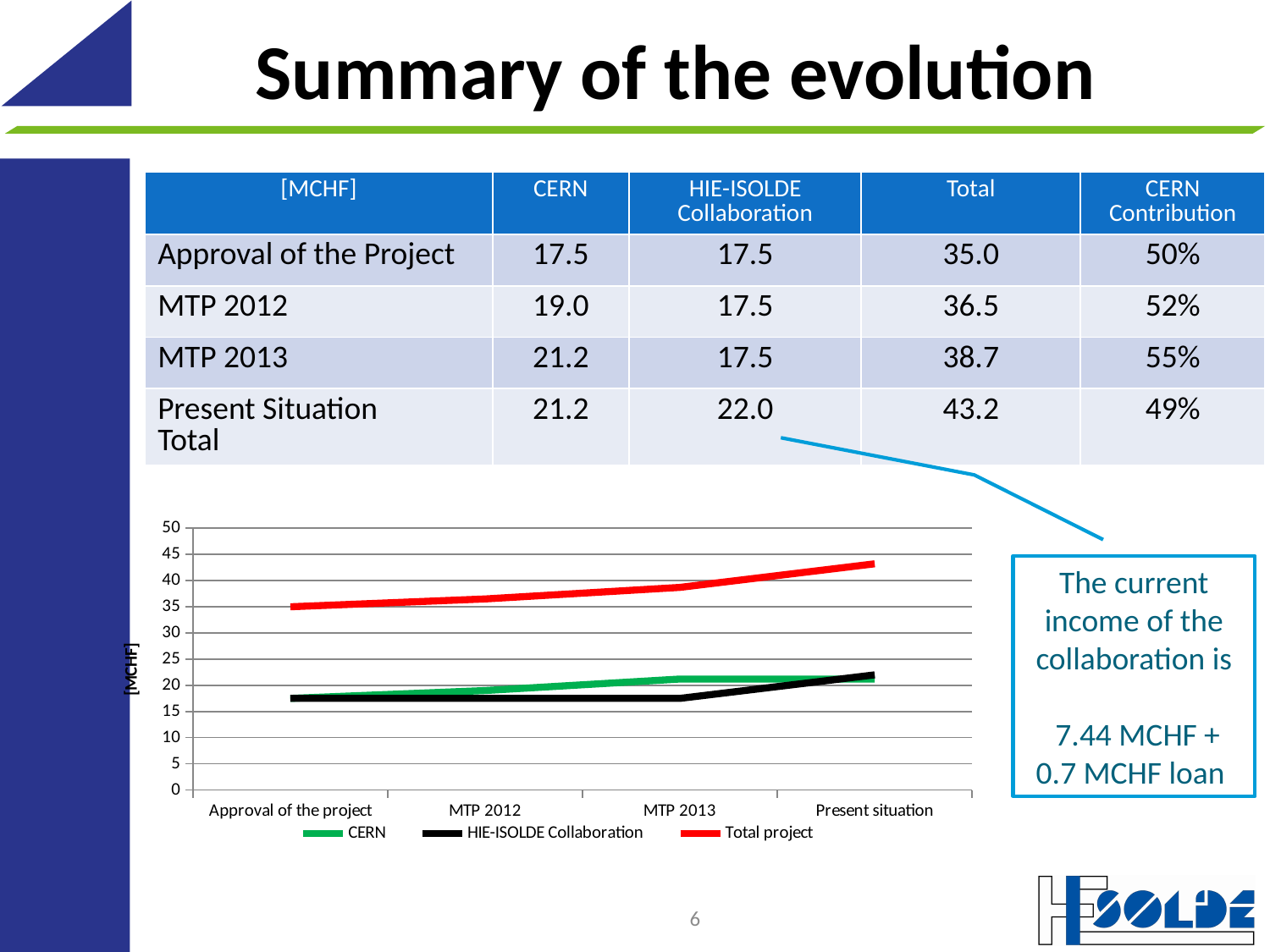
At MTP 2013, which is larger: the CERN line or the HIE-ISOLDE Collaboration line? CERN Is the value of the CERN line at Approval of the project greater or less than 20? less At which x-axis category does the Total project line reach its highest value? Present situation How many series does the chart legend list? 3 Is the value of the Total project line at Present situation greater or less than 40? greater What kind of chart is shown on the slide? line chart According to the table on the slide, what is the Total value plotted for MTP 2013? 38.7 How many categories are shown along the x axis of the chart? 4 What colour is the Total project line in the chart? red Using the table values, what is the difference between the Total at Present Situation Total and the Total at Approval of the Project? 8.2 Does the Total project line rise or fall from Approval of the project to Present situation? rise Is the value of the HIE-ISOLDE Collaboration line at Present situation greater or less than 20? greater